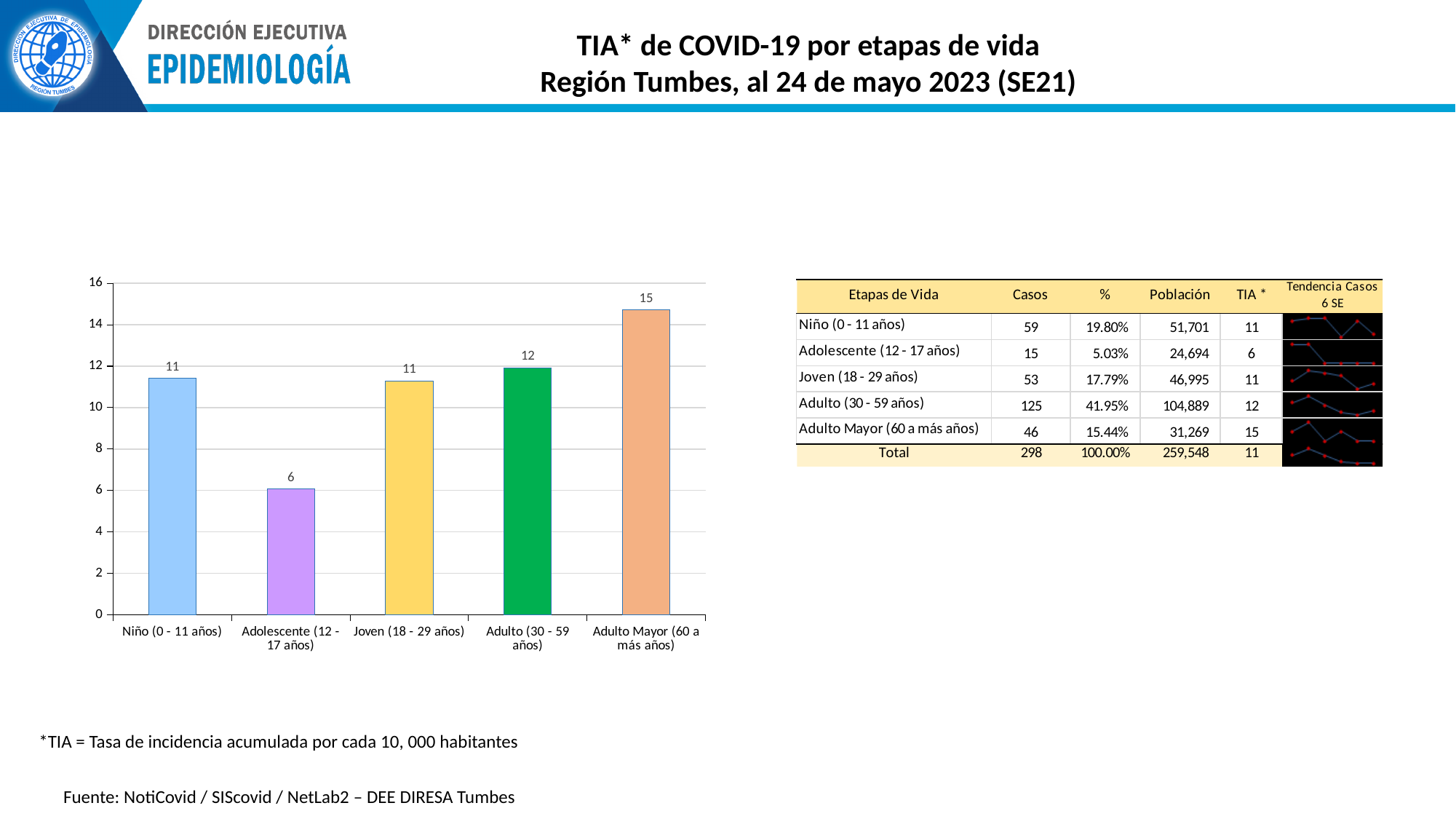
Is the TIA value for Adulto Mayor (60 a más años) in the bar chart greater or less than 14? greater Which life stage has the lowest TIA in the bar chart? Adolescente (12 - 17 años) Which life stage has the highest TIA in the bar chart? Adulto Mayor (60 a más años) How many life-stage categories are shown in the bar chart? 5 What is the TIA value shown for Adulto (30 - 59 años) in the bar chart? 12 What is the maximum value shown on the vertical axis of the bar chart? 16 What is the TIA value shown for Adulto Mayor (60 a más años) in the bar chart? 15 In the bar chart, which is larger: the TIA for Adulto Mayor (60 a más años) or for Adulto (30 - 59 años)? Adulto Mayor (60 a más años) What type of chart is used to show TIA by life stage on the slide? Bar chart What is the TIA value shown for Adolescente (12 - 17 años) in the bar chart? 6 Is the TIA value for Adolescente (12 - 17 años) in the bar chart greater or less than 8? less What is the difference between the TIA for Adulto Mayor (60 a más años) and Adolescente (12 - 17 años) in the bar chart? 9